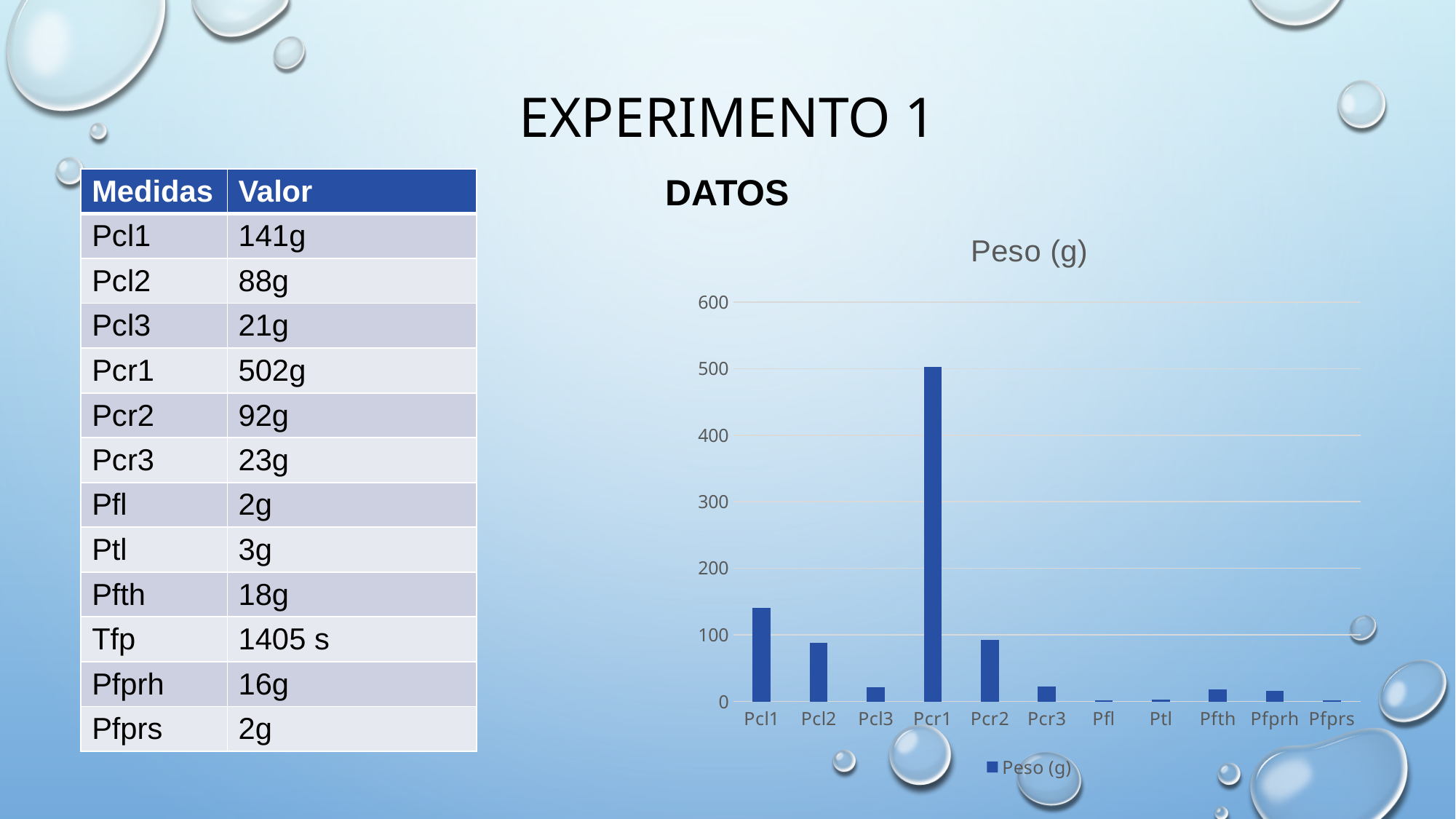
According to the table on the slide, what is the value for Pcr1 plotted in the chart? 502g What kind of chart is shown on the slide? bar chart How many series does the chart's legend list? 1 Which category has the highest bar in the chart? Pcr1 What entry does the chart's legend show? Peso (g) Is the value for Pcl1 greater or less than 200? less What is the title of the chart? Peso (g) Which is larger in the chart, the value for Pcr2 or the value for Pcr3? Pcr2 Is the value for Pcl2 greater or less than 100? less How many categories are plotted along the x axis of the chart? 11 Is the value for Pcr1 greater or less than 400? greater Which is larger in the chart, the value for Pcl1 or the value for Pcr2? Pcl1